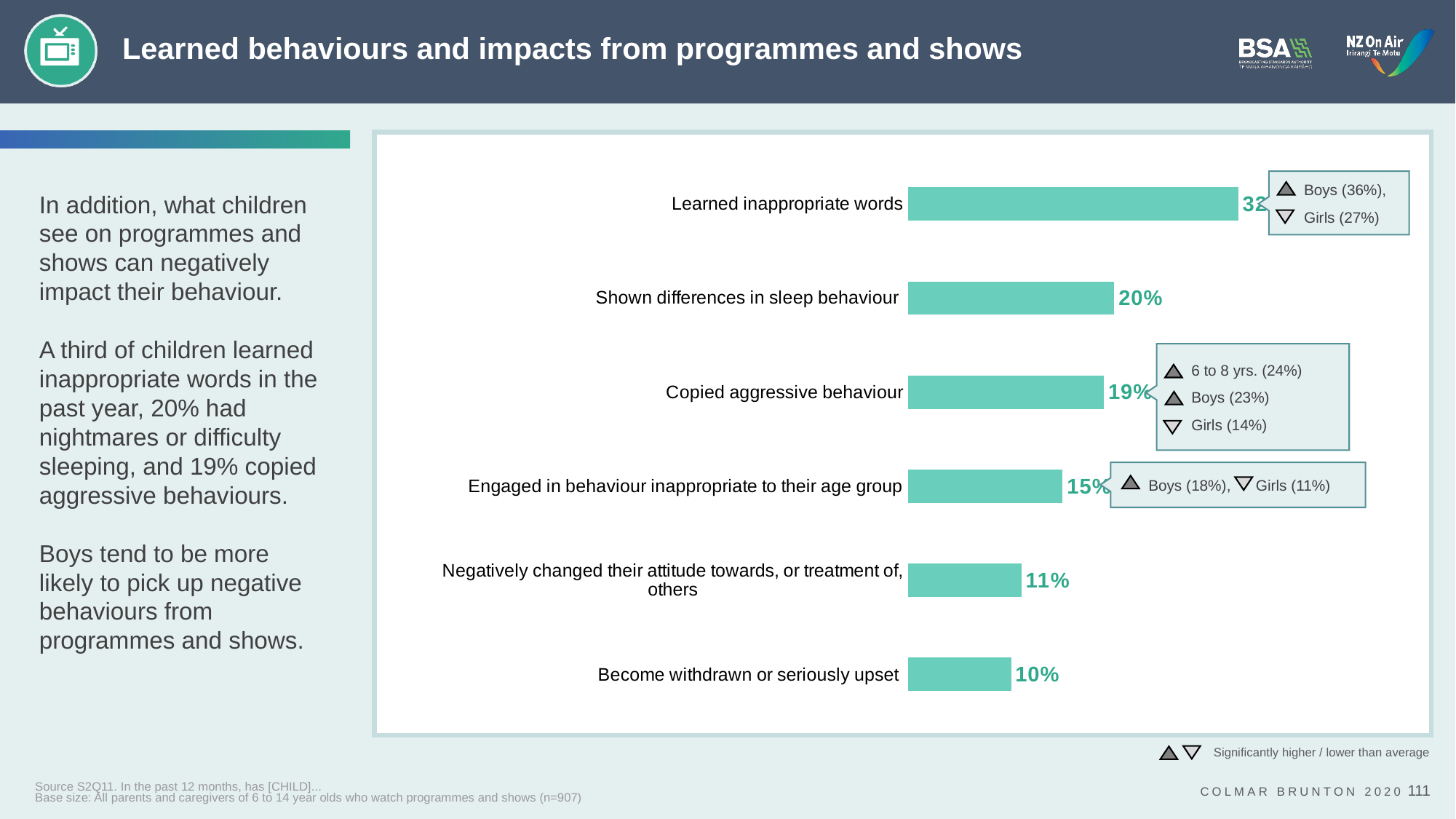
Which is larger: the value for 'Copied aggressive behaviour' or for 'Engaged in behaviour inappropriate to their age group'? Copied aggressive behaviour What is the value for 'Negatively changed their attitude towards, or treatment of, others'? 11% According to the callout, what percentage of girls copied aggressive behaviour? 14% Which behaviour has the lowest percentage in the chart? Become withdrawn or seriously upset What is the difference between the value for 'Shown differences in sleep behaviour' and 'Become withdrawn or seriously upset'? 10 percentage points What percentage of children have shown differences in sleep behaviour? 20% What is the value shown for 'Copied aggressive behaviour'? 19% What percentage of children have become withdrawn or seriously upset? 10% Which behaviour has the highest percentage in the chart? Learned inappropriate words What kind of chart is shown on the slide? Bar chart How many behaviours are listed in the chart? 6 What percentage of children engaged in behaviour inappropriate to their age group? 15%